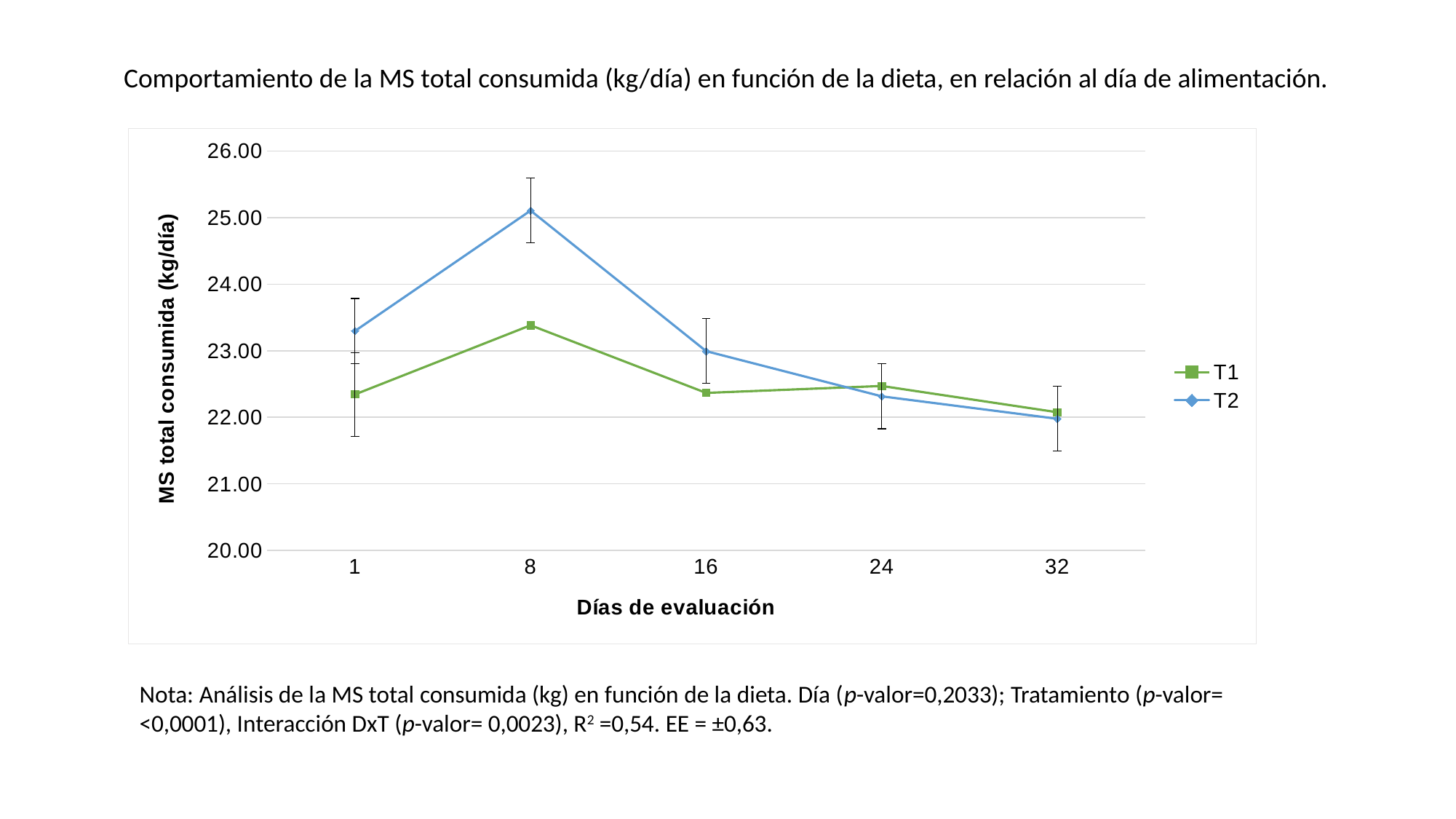
At day 8, which series has the larger value, T1 or T2? T2 At day 1, which series has the larger value, T1 or T2? T2 Does the T2 series rise or fall from day 8 to day 32? fall What kind of chart is shown on the slide? line chart How many series does the legend list? 2 On which evaluation day does the T2 series reach its lowest value? 32 What is the title of the y axis? MS total consumida (kg/día) On which evaluation day does the T1 series reach its highest value? 8 Is the value for T2 at day 8 greater or less than 24.00? greater How many evaluation days are plotted along the x axis? 5 On which evaluation day does the T2 series reach its highest value? 8 Is the value for T1 at day 1 greater or less than 23.00? less